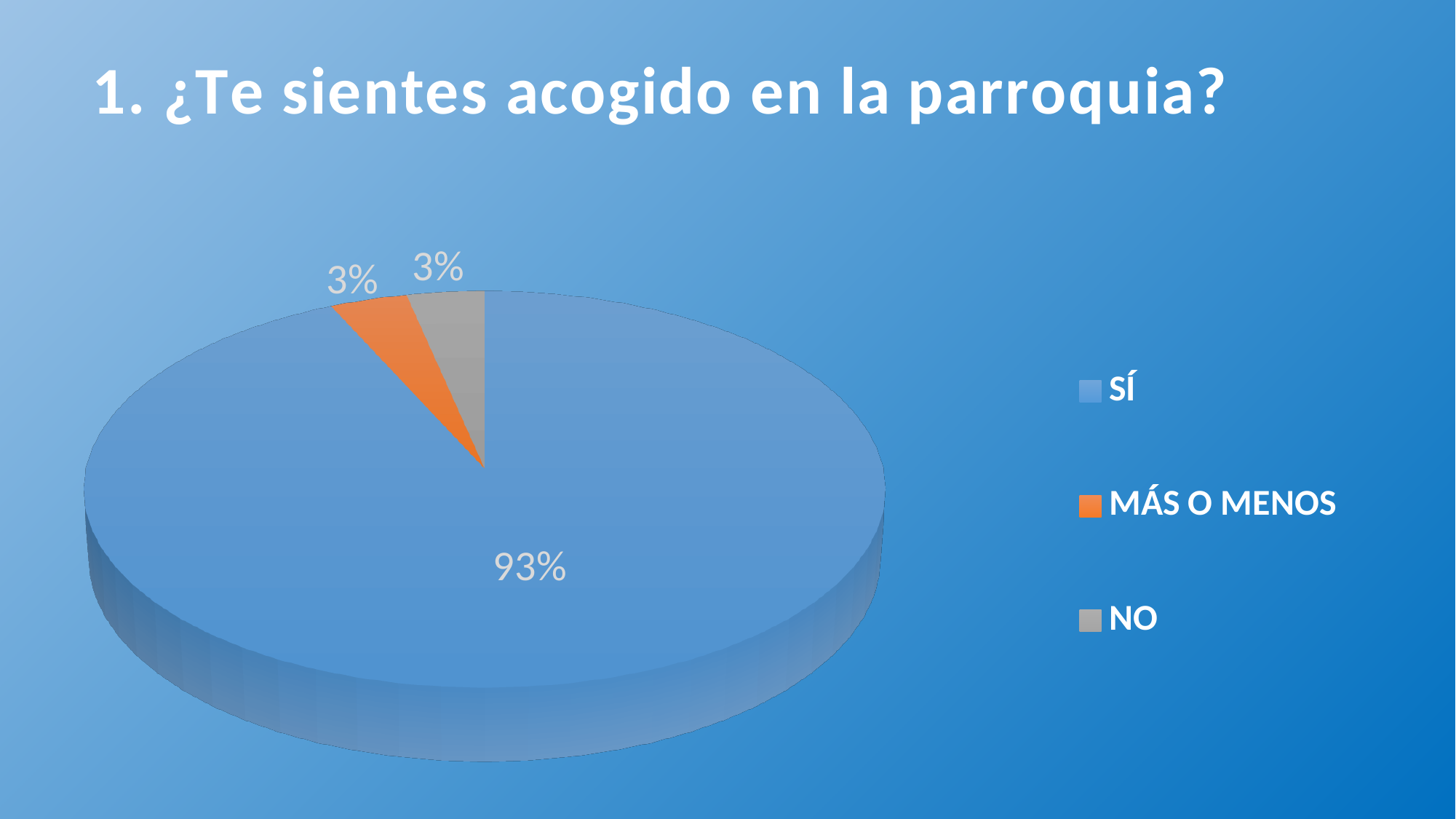
What percentage of respondents answered NO? 3% Which response has the largest share of the pie? SÍ What percentage of respondents answered SÍ? 93% Which is larger, the share for SÍ or the share for MÁS O MENOS? SÍ What is the title of the chart? 1. ¿Te sientes acogido en la parroquia? What colour is the slice for MÁS O MENOS? Orange What percentage of respondents answered MÁS O MENOS? 3% How many entries does the legend list? 3 What kind of chart is shown on the slide? Pie chart How many slices does the pie chart have? 3 What is the difference in percentage points between SÍ and NO? 90